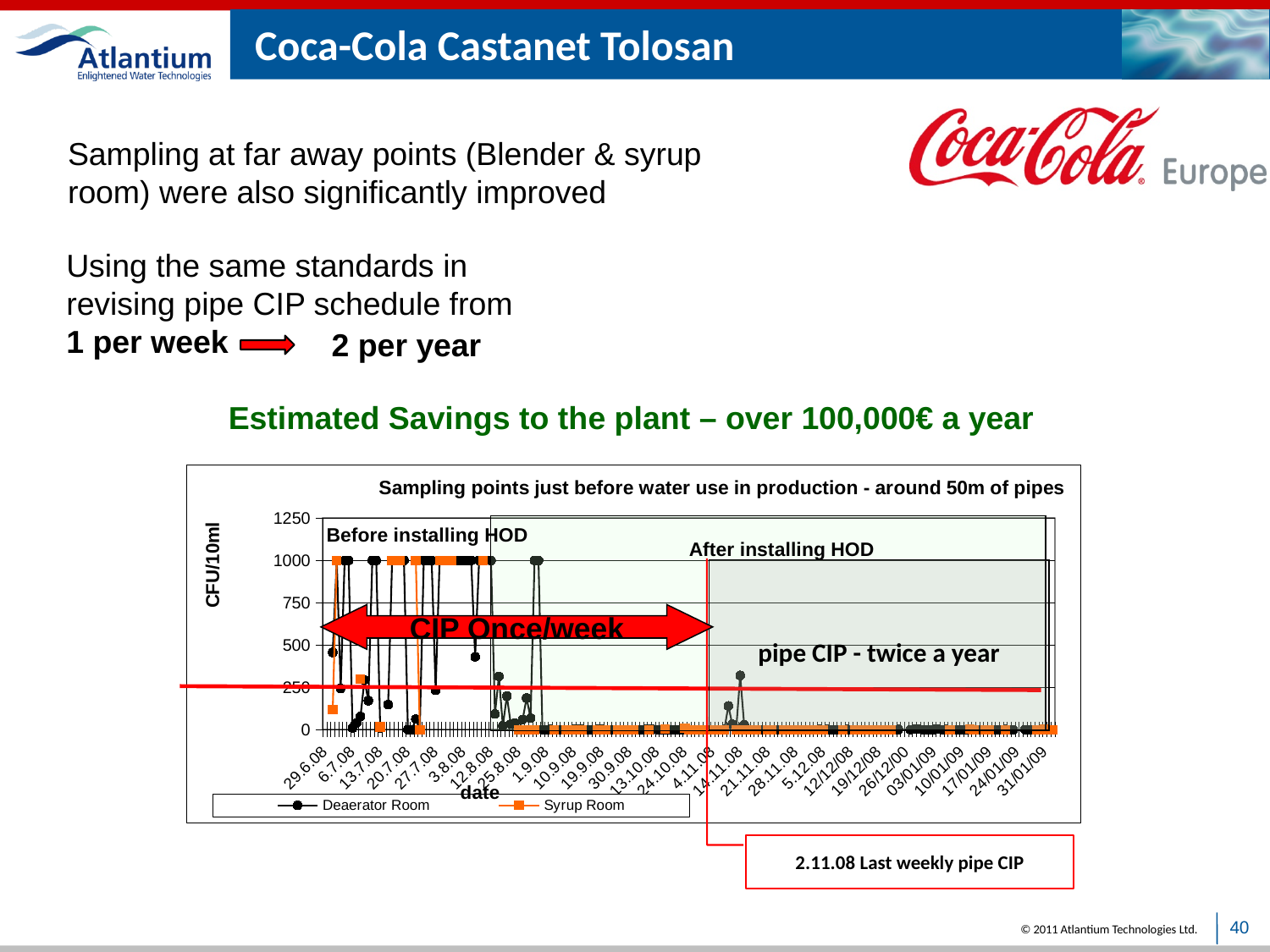
What is the title of the chart? Sampling points just before water use in production - around 50m of pipes What are the two series named in the chart's legend? Deaerator Room and Syrup Room Do the plotted CFU/10ml values generally rise or fall along the date axis from June 2008 to January 2009? fall Are the Syrup Room values plotted after 25.8.08 greater or less than 250? less What kind of chart is shown on the slide? line chart Is the highest Deaerator Room value on the chart greater or less than 750? greater Are the Deaerator Room values plotted after 14.11.08 greater or less than 500? less How many series does the chart's legend list? 2